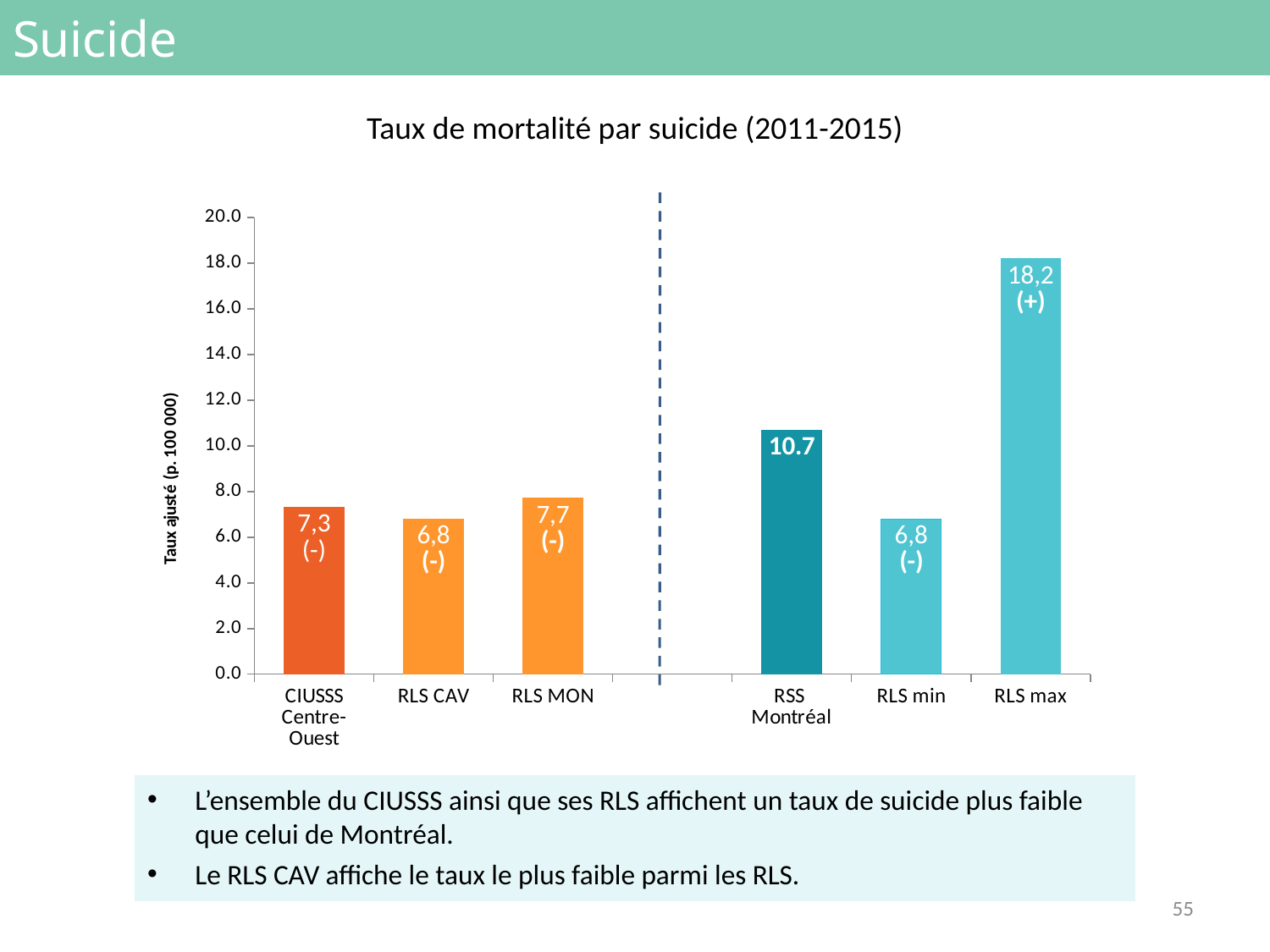
What is the value shown for RSS Montréal? 10.7 Which category has the highest value in the chart? RLS max What is the title of the chart? Taux de mortalité par suicide (2011-2015) Which is larger, the value for RLS MON or the value for CIUSSS Centre-Ouest? RLS MON What type of chart is shown on the slide? bar chart How many bars are plotted in the chart? 6 What is the difference between the values for RLS max and RSS Montréal? 7,5 Among CIUSSS Centre-Ouest, RLS CAV and RLS MON, which has the lowest value? RLS CAV What is the value shown for RLS MON? 7,7 What is the value shown for CIUSSS Centre-Ouest? 7,3 What is the value shown for RLS max? 18,2 What is the label of the vertical axis? Taux ajusté (p. 100 000)